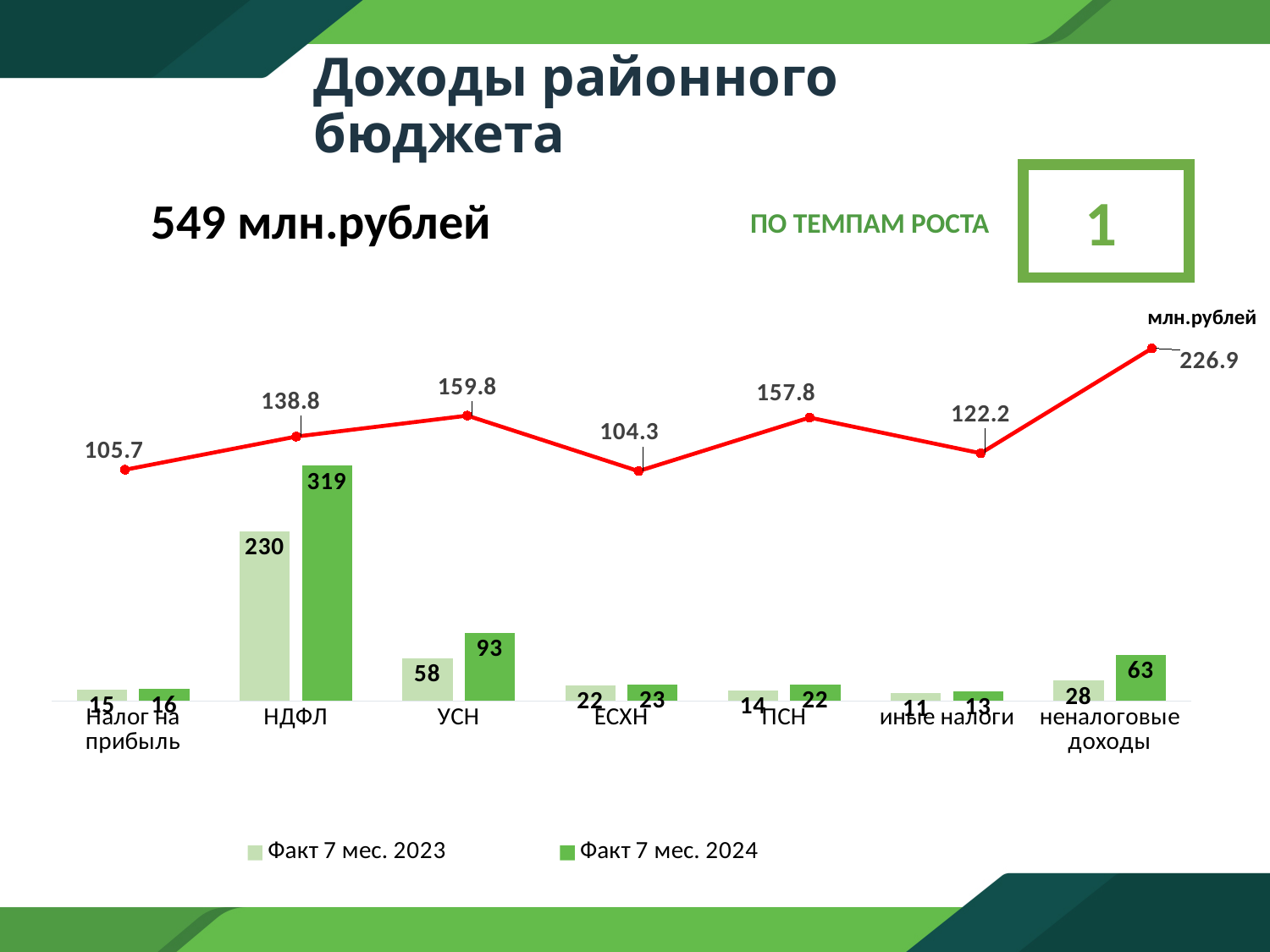
What is the difference between Факт 7 мес. 2024 and Факт 7 мес. 2023 for НДФЛ? 89 Which category has the lowest value on the red line? ЕСХН How many categories are shown on the x axis? 7 Which category has the highest Факт 7 мес. 2024 value? НДФЛ What is the value of Факт 7 мес. 2024 for НДФЛ? 319 How many series does the legend list? 2 What value does the red line show for неналоговые доходы? 226.9 What is the total shown above the chart for district budget revenues? 549 млн.рублей Which category has the lowest Факт 7 мес. 2023 value? иные налоги What is the value of Факт 7 мес. 2023 for УСН? 58 Which is larger for неналоговые доходы: Факт 7 мес. 2023 or Факт 7 мес. 2024? Факт 7 мес. 2024 What value does the red line show for ЕСХН? 104.3